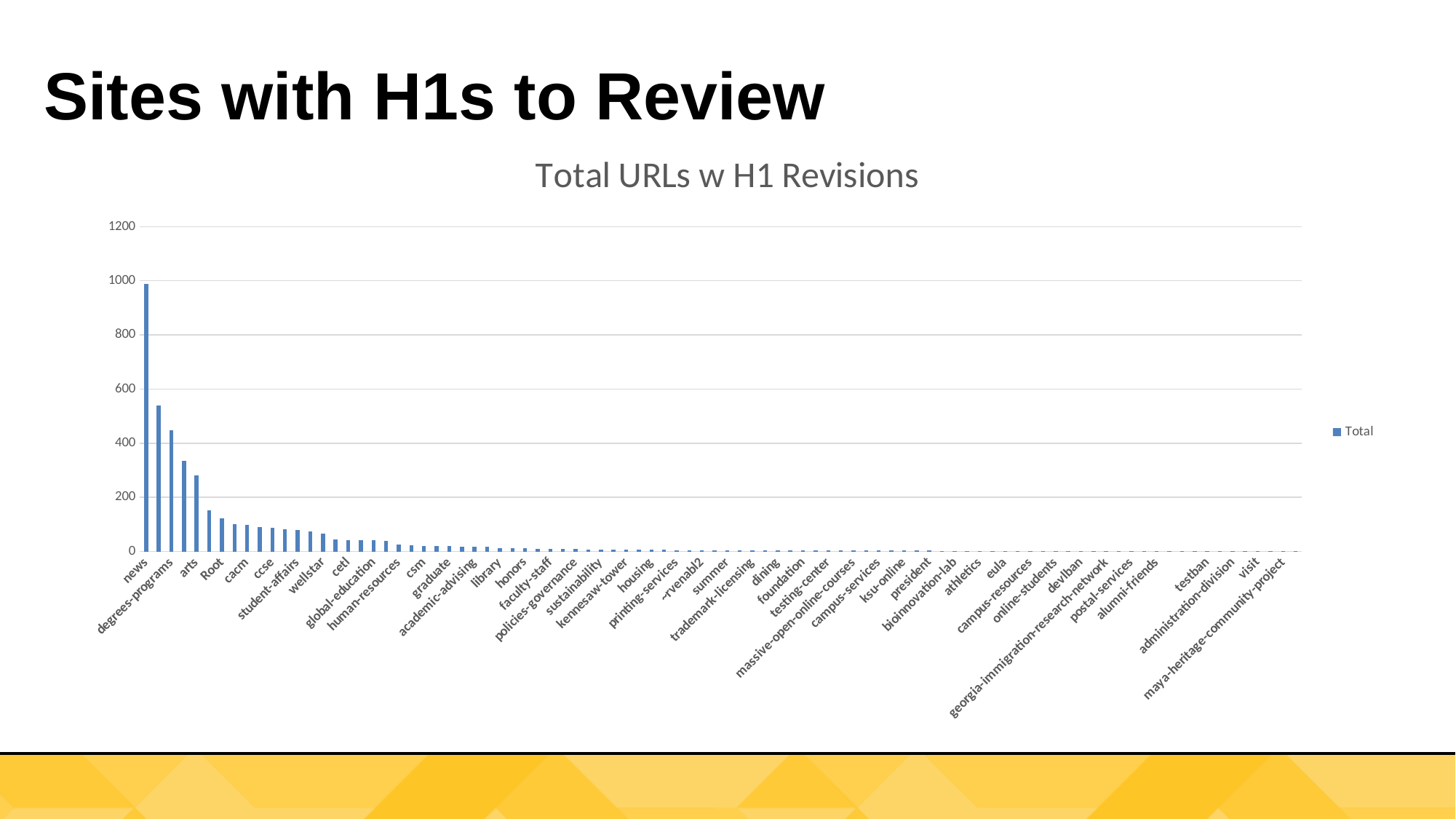
Is the value for arts greater or less than 600? less Is the value for news greater or less than 800? greater Which has a larger value, degrees-programs or Root? degrees-programs What kind of chart is shown on the slide? bar chart What is the name of the series shown in the legend? Total Do the values rise or fall moving from left to right along the x axis? fall Which has a larger value, news or arts? news Is the value for cacm greater or less than 200? less Which site has the highest total of URLs with H1 revisions? news How many series does the legend list? 1 What is the title of the chart? Total URLs w H1 Revisions